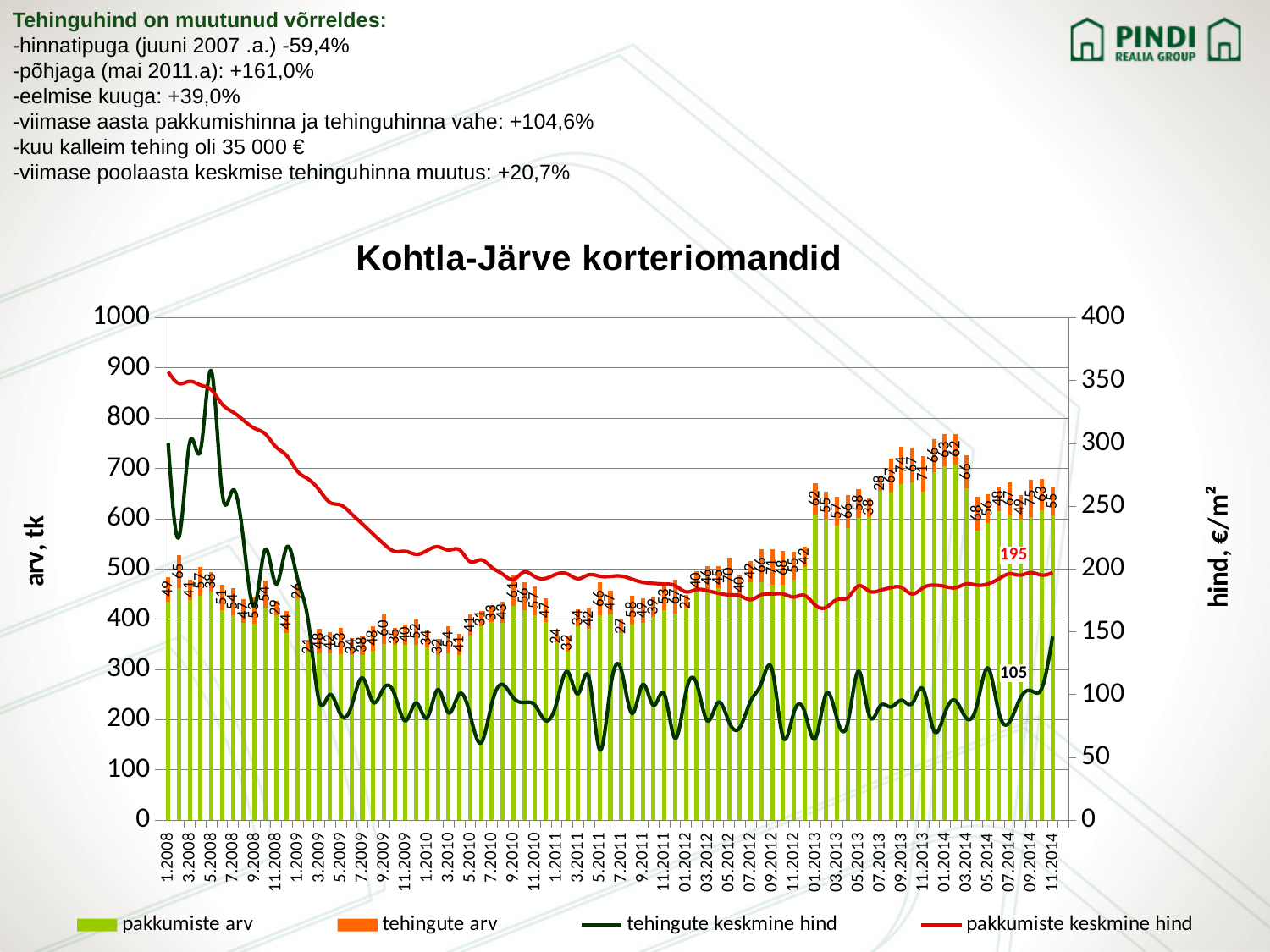
Is the pakkumiste keskmine hind value at 1.2008 greater or less than 300 €/m²? greater What is the label of the right-hand vertical axis? hind, €/m² Does the pakkumiste keskmine hind line rise or fall overall from 1.2008 to 11.2014? fall What is the difference between the final labelled values of pakkumiste keskmine hind (195) and tehingute keskmine hind (105)? 90 How many series does the chart legend list? 4 What is the last labelled value of the pakkumiste keskmine hind line (11.2014)? 195 What is the last labelled value of the tehingute keskmine hind line (11.2014)? 105 What is the title of the chart? Kohtla-Järve korteriomandid At the end of the series (11.2014), which is higher: pakkumiste keskmine hind or tehingute keskmine hind? pakkumiste keskmine hind What kind of chart is this? Combined bar and line chart What is the data label on the tehingute arv series for the first month, 1.2008? 49 Is the pakkumiste arv bar at 01.2014 greater or less than 600? greater